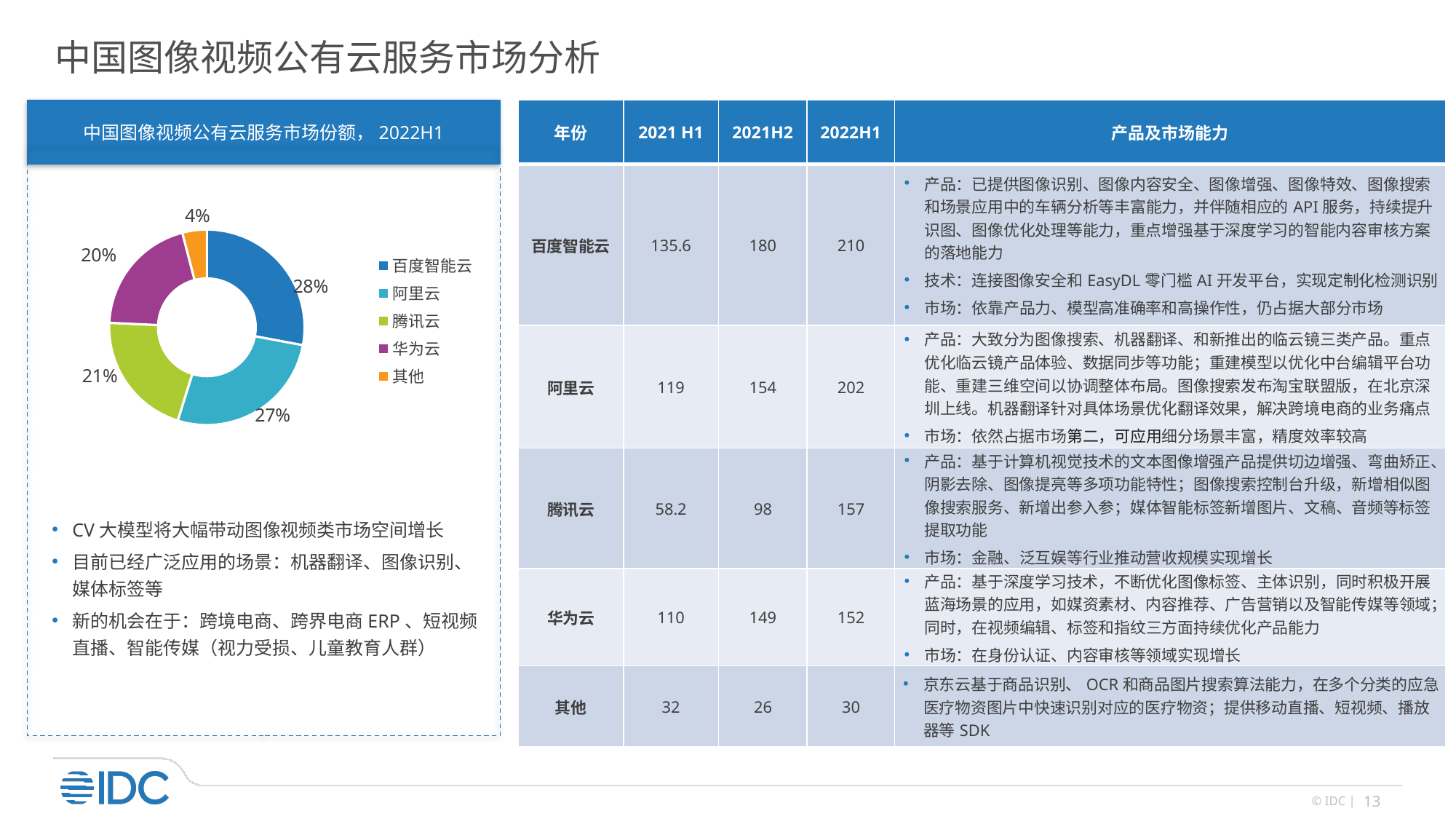
What share of the market does 其他 hold in the chart? 4% What is the title of the chart? 中国图像视频公有云服务市场份额，2022H1 What share of the market does 阿里云 hold in the chart? 27% Which colour represents 腾讯云 in the chart? Green How many categories does the chart's legend list? 5 What share of the market does 百度智能云 hold in the chart? 28% What is the difference between the shares of 百度智能云 and 华为云 in the chart? 8% Which category has the largest share in the chart? 百度智能云 What share of the market does 华为云 hold in the chart? 20% What share of the market does 腾讯云 hold in the chart? 21% Which category has the smallest share in the chart? 其他 What kind of chart is shown on the slide? Pie chart (donut)